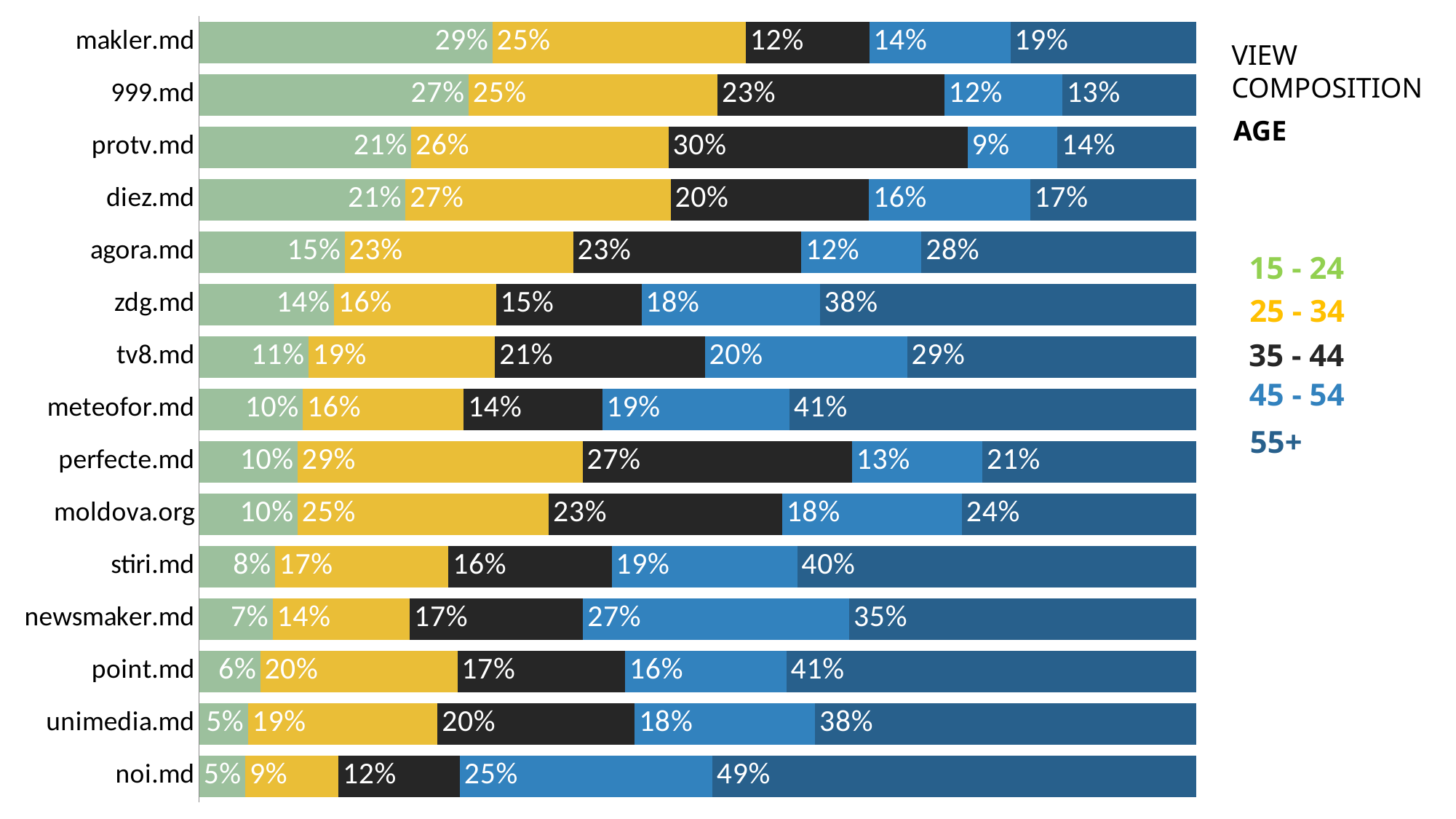
What share of views on makler.md comes from the 15 - 24 age group? 29% What is the 35 - 44 share for protv.md? 30% Which website has the highest 15 - 24 share? makler.md What percentage of noi.md views comes from the 55+ age group? 49% What is the difference between the 55+ share of zdg.md and the 55+ share of makler.md? 19% What is the 45 - 54 share for newsmaker.md? 27% What type of chart is shown on the slide? Stacked bar chart How many websites are shown in the chart? 15 Which website has the highest 55+ share? noi.md Which is larger: the 35 - 44 share for 999.md or the 35 - 44 share for diez.md? 999.md Which website has the lowest 25 - 34 share? noi.md How many age groups does the legend list? 5